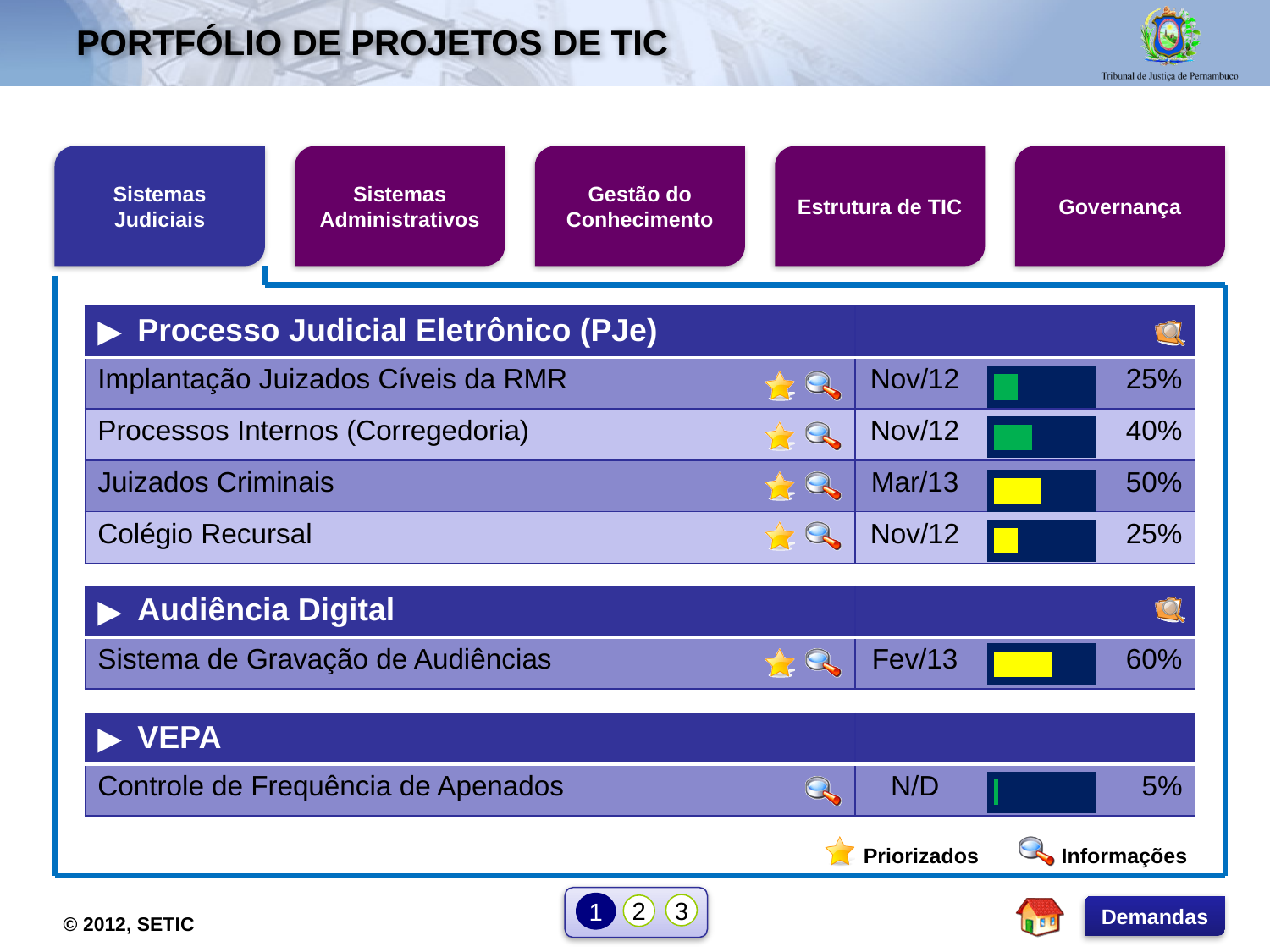
What date is shown for Juizados Criminais? Mar/13 Which project has the lowest completion percentage on the slide? Controle de Frequência de Apenados What date is shown for Controle de Frequência de Apenados? N/D What is the completion percentage shown for Processos Internos (Corregedoria)? 40% How many projects are listed under Processo Judicial Eletrônico (PJe)? 4 What is the difference in completion percentage between Sistema de Gravação de Audiências and Controle de Frequência de Apenados? 55% Which project has the highest completion percentage on the slide? Sistema de Gravação de Audiências Which has a higher completion percentage, Juizados Criminais or Processos Internos (Corregedoria)? Juizados Criminais What is the completion percentage shown for Sistema de Gravação de Audiências? 60% What colour is the progress bar for Juizados Criminais? Yellow How many projects with progress bars are shown on the slide in total? 6 What is the completion percentage shown for Implantação Juizados Cíveis da RMR? 25%